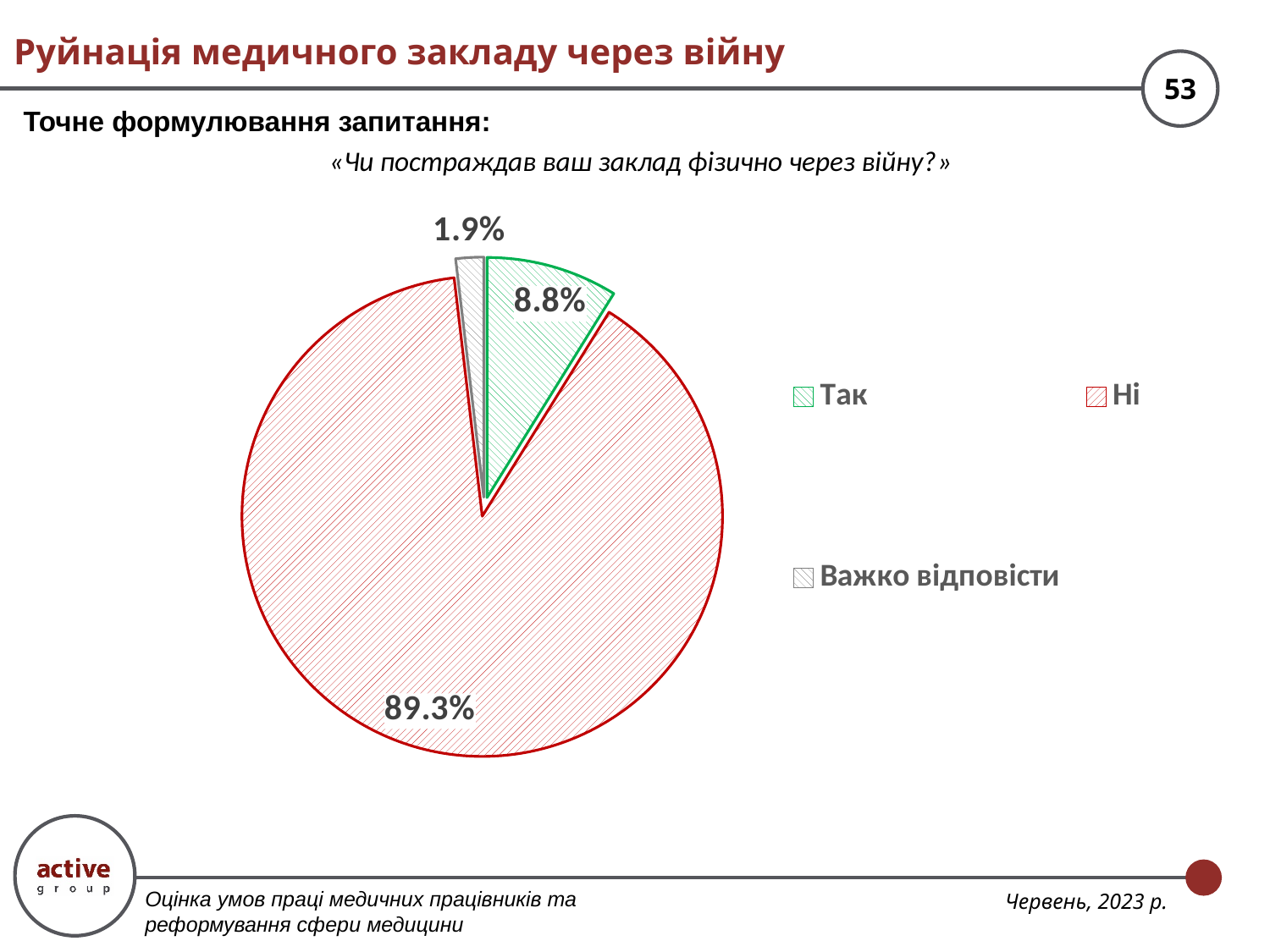
Which answer has the largest share of the pie? Ні How many entries does the legend list? 3 What share of respondents answered "Так" (Yes)? 8.8% Which answer has the smallest share of the pie? Важко відповісти Which legend entry is shown with green hatching? Так Which is larger, the share for "Так" or the share for "Важко відповісти"? Так What kind of chart is shown on the slide? Pie chart What share of respondents answered "Важко відповісти"? 1.9% What is the difference in percentage points between "Ні" and "Так"? 80.5 What share of respondents answered "Ні" (No)? 89.3% What is the combined share of "Так" and "Важко відповісти"? 10.7% How many slices does the pie chart have? 3